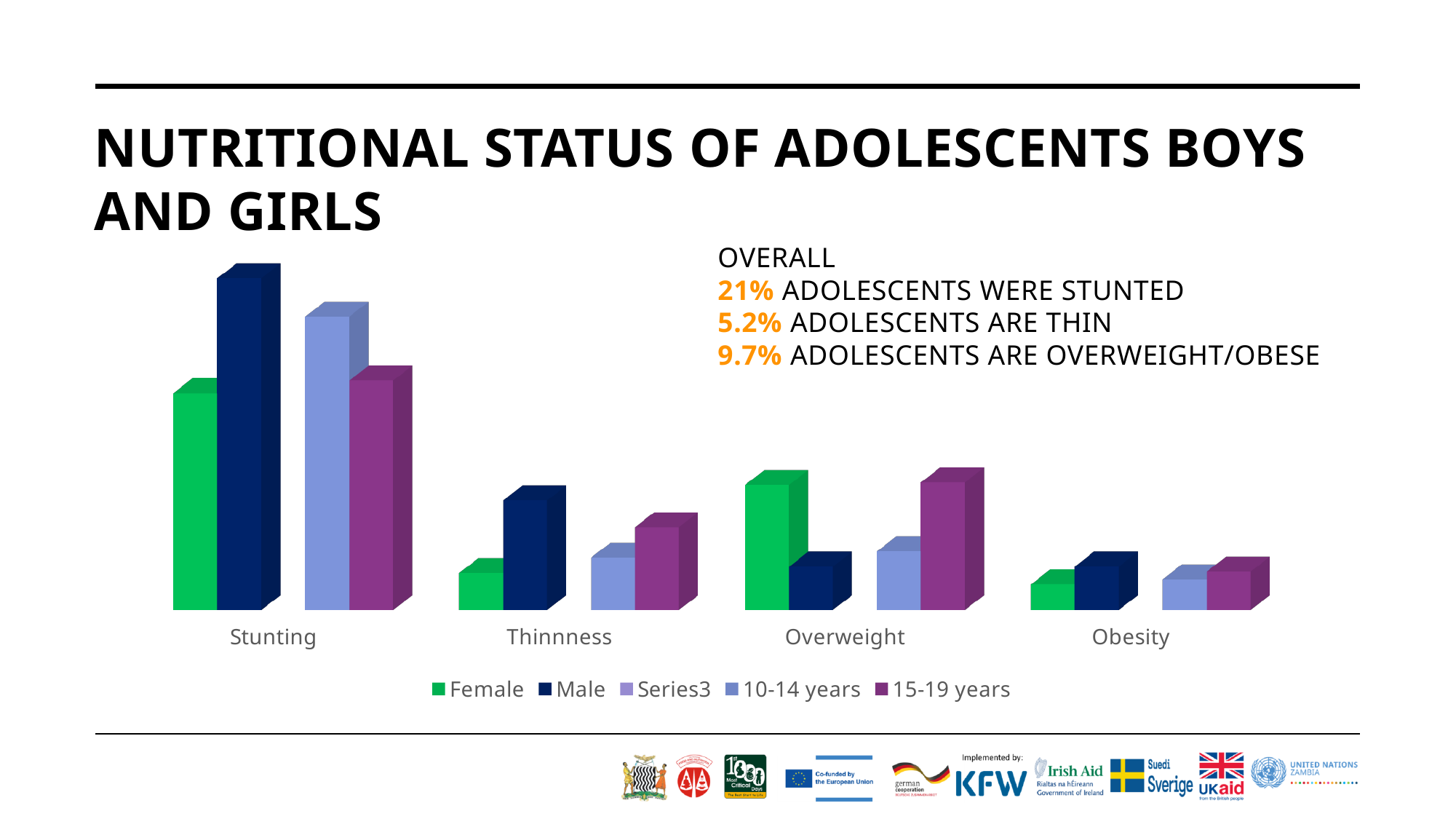
How many series does the chart legend list? 5 How many categories are shown on the x axis of the chart? 4 For Thinnness, is the Male value or the Female value larger? Male Which category has the tallest bars in the chart? Stunting Which series has the highest value for Stunting? Male Which series has the lowest value for Thinnness? Female Which series has the lowest value for Overweight? Male Which category has the shortest bars in the chart? Obesity What kind of chart is shown on the slide? bar chart What is the title of the slide containing the chart? NUTRITIONAL STATUS OF ADOLESCENTS BOYS AND GIRLS For Overweight, is the 10-14 years value or the 15-19 years value larger? 15-19 years For Overweight, is the Female value or the Male value larger? Female